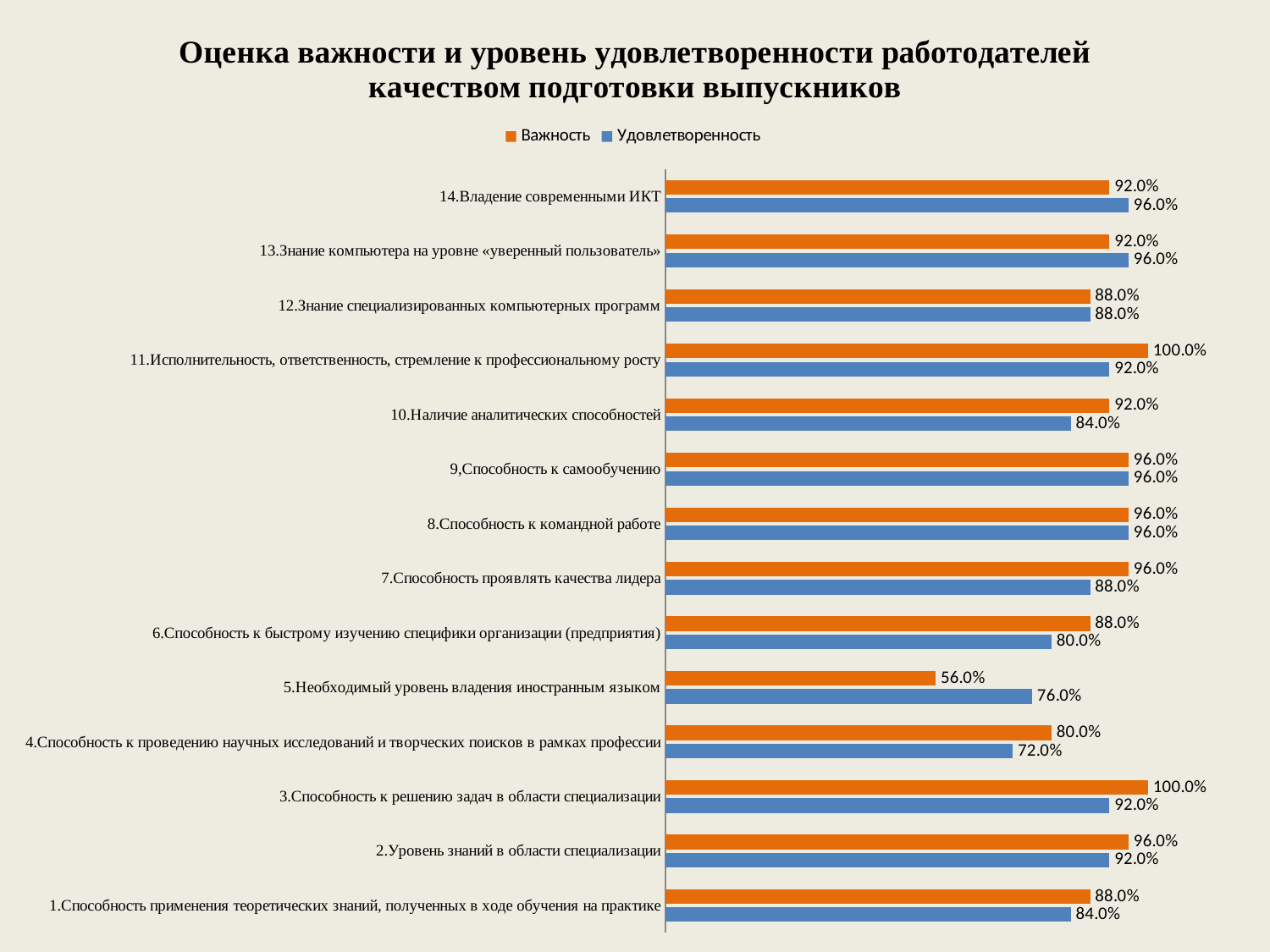
What type of chart is shown on the slide? bar chart Which category has the lowest Важность value? 5.Необходимый уровень владения иностранным языком What is the difference between the Важность and Удовлетворенность values for "3.Способность к решению задач в области специализации"? 8.0% For "7.Способность проявлять качества лидера", which is larger: Важность or Удовлетворенность? Важность Which colour represents the Удовлетворенность series in the chart? blue What is the Важность value for "11.Исполнительность, ответственность, стремление к профессиональному росту"? 100.0% How many series does the legend list? 2 Which category has the lowest Удовлетворенность value? 4.Способность к проведению научных исследований и творческих поисков в рамках профессии What is the Удовлетворенность value for "10.Наличие аналитических способностей"? 84.0% How many categories are plotted in the chart? 14 What is the Важность value for "5.Необходимый уровень владения иностранным языком"? 56.0% What is the difference between the Важность and Удовлетворенность values for "5.Необходимый уровень владения иностранным языком"? 20.0%